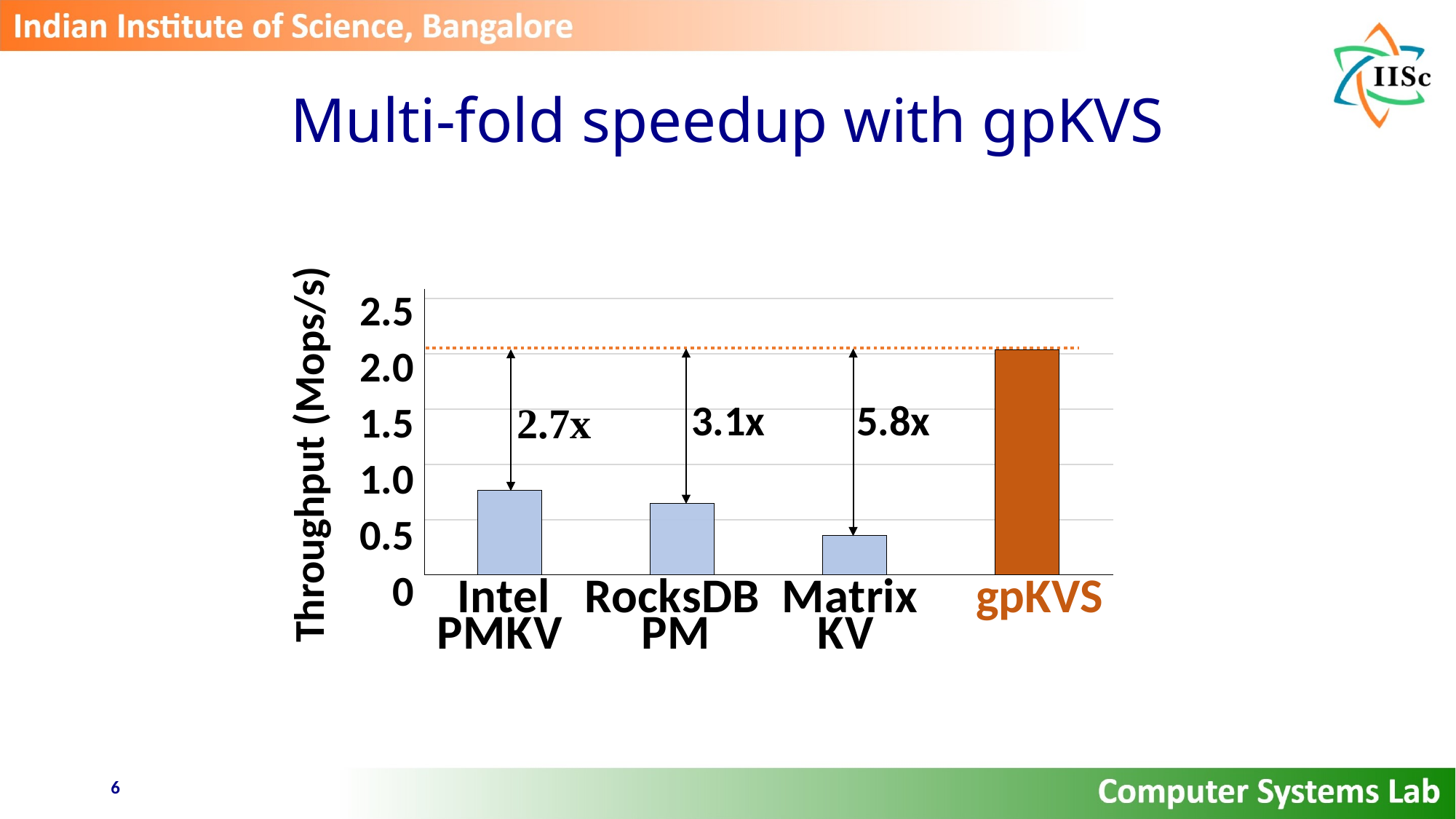
Which category has the highest throughput? gpKVS Is the throughput for Intel PMKV greater or less than 1.0 Mops/s? less What speedup factor is annotated for gpKVS over Matrix KV? 5.8x What is the label of the y axis? Throughput (Mops/s) What speedup factor is annotated for gpKVS over RocksDB PM? 3.1x Which category has the lowest throughput? Matrix KV What is the title of the slide containing the chart? Multi-fold speedup with gpKVS Is the throughput for gpKVS greater or less than 2.0 Mops/s? greater Which has higher throughput, Intel PMKV or Matrix KV? Intel PMKV Is the throughput for Matrix KV greater or less than 0.5 Mops/s? less How many categories are plotted on the x axis of the chart? 4 What kind of chart is shown on the slide? bar chart